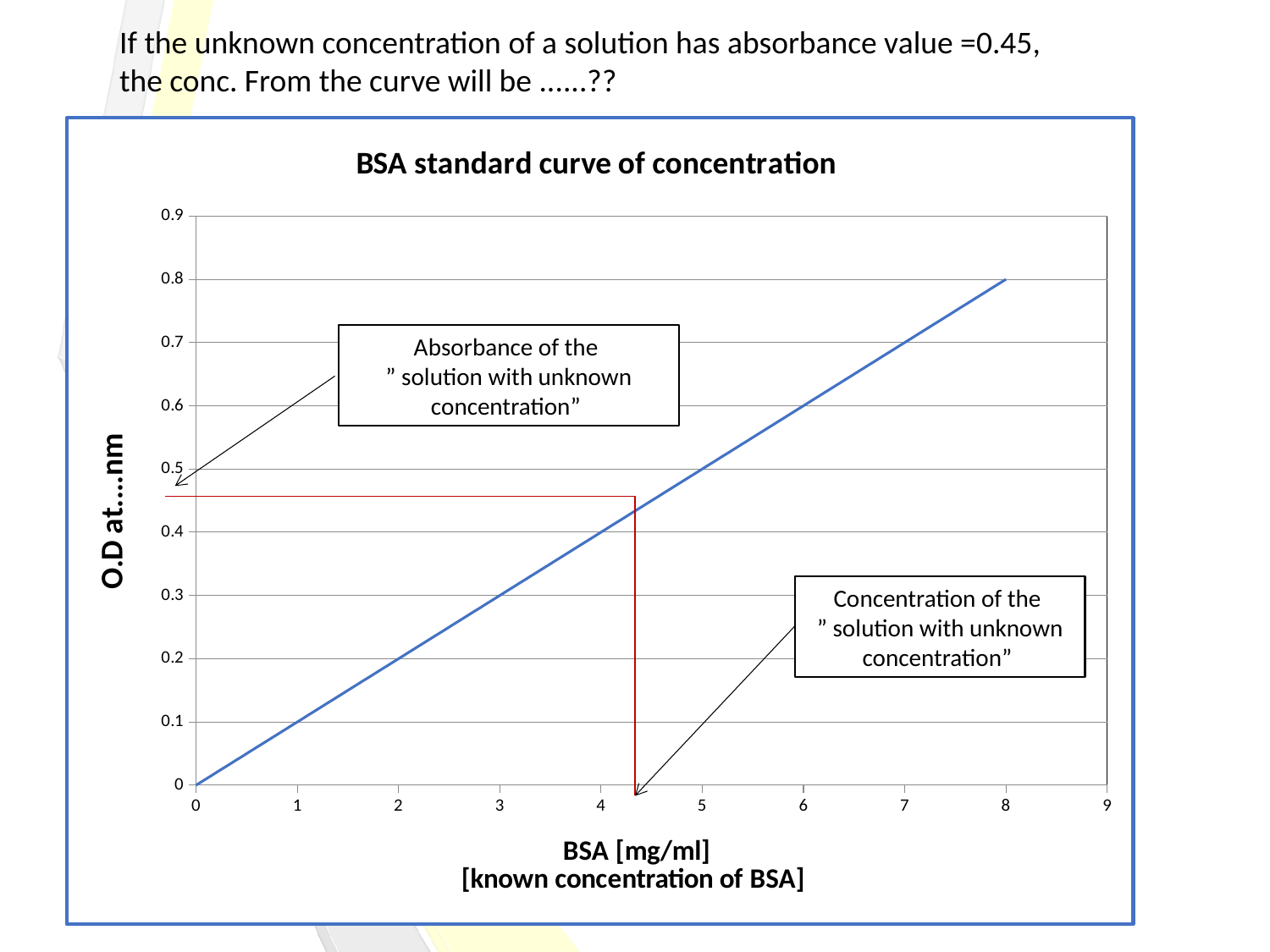
What is the title of the chart? BSA standard curve of concentration Is the O.D. value at a BSA concentration of 6 mg/ml greater or less than 0.5? greater What O.D. value does the line reach at a BSA concentration of 8 mg/ml? 0.8 What kind of chart is shown on the slide? line chart At which BSA concentration shown does the line reach its highest O.D. value? 8 Is the O.D. value at a BSA concentration of 2 mg/ml greater or less than 0.3? less At which BSA concentration shown does the line have its lowest O.D. value? 0 Does the O.D. value rise or fall as the BSA concentration increases along the x axis? rise Is the O.D. value at a BSA concentration of 7 mg/ml greater or less than 0.6? greater What O.D. value does the line have at a BSA concentration of 0 mg/ml? 0 Which has the higher O.D. value: a BSA concentration of 3 mg/ml or 5 mg/ml? 5 mg/ml What is the label of the x axis of the chart? BSA [mg/ml] [known concentration of BSA]